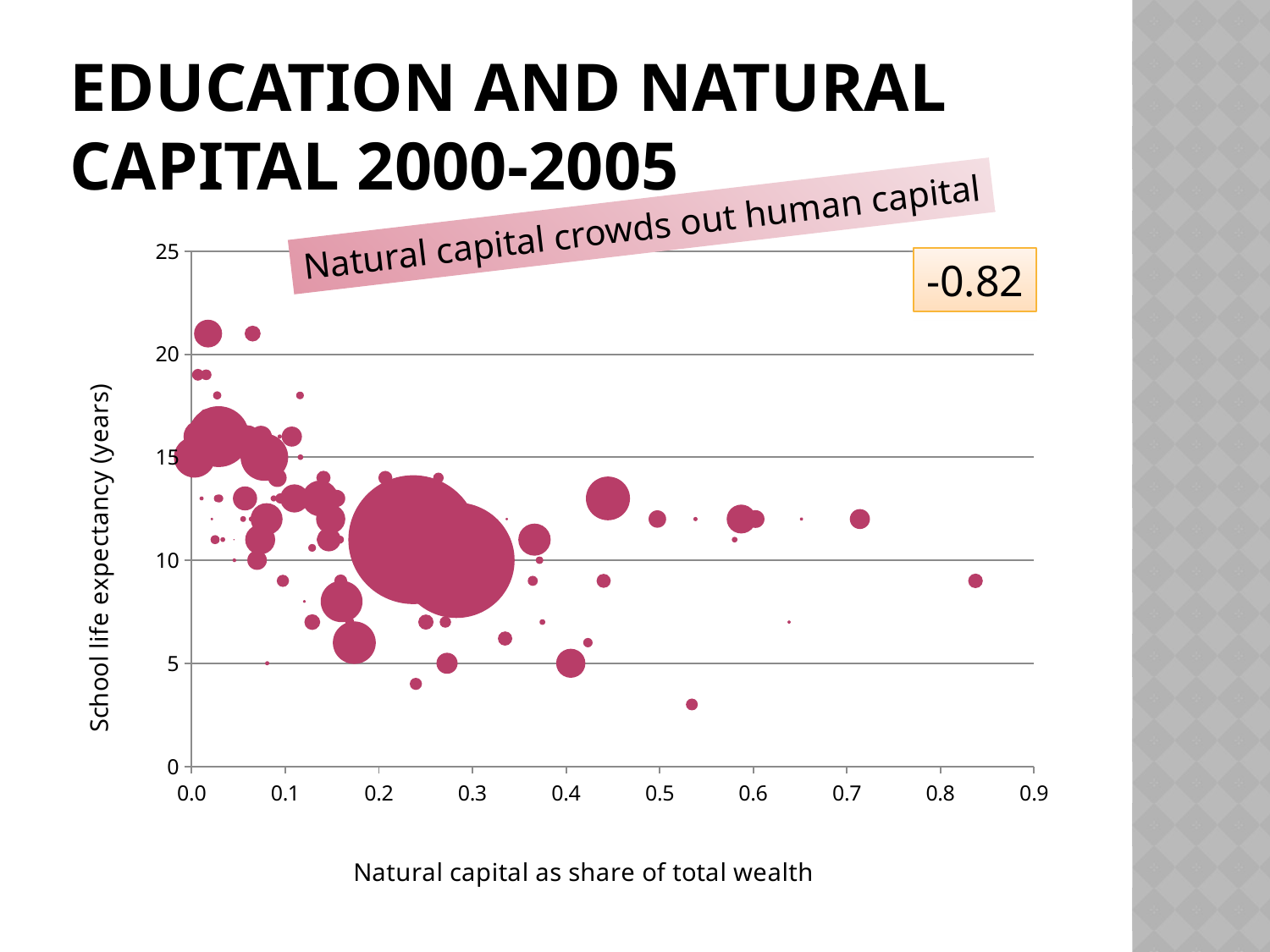
As natural capital as a share of total wealth increases along the x axis, do the school life expectancy values generally rise or fall? fall What correlation value is printed in the box at the top right of the chart? -0.82 What is the title of the x axis of the chart? Natural capital as share of total wealth What kind of chart is shown on the slide? bubble chart